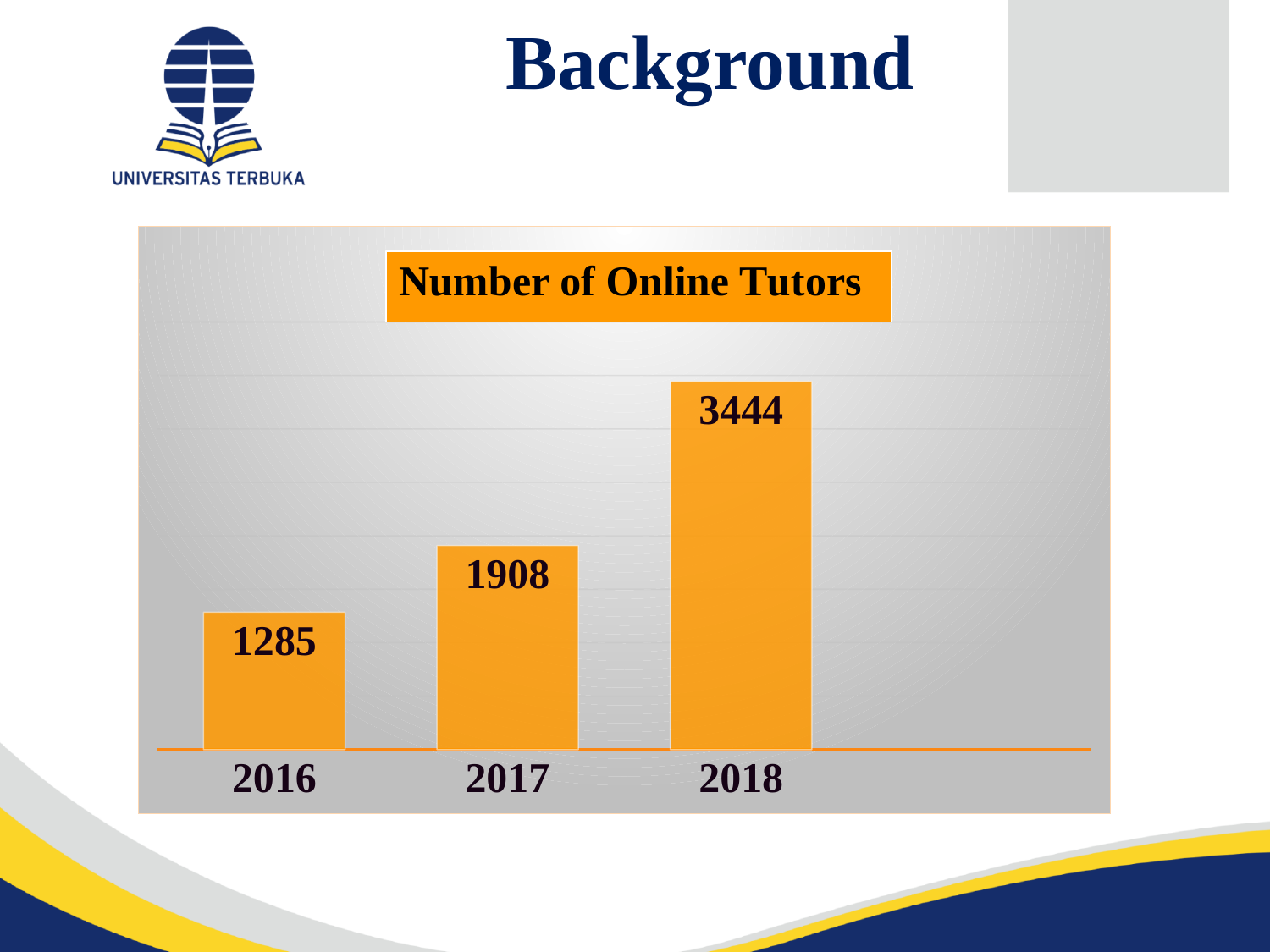
What kind of chart is shown on the slide? Bar chart What is the difference in the number of online tutors between 2018 and 2017? 1536 Which year has more online tutors, 2016 or 2017? 2017 What is the number of online tutors in 2016? 1285 Which year has the highest number of online tutors? 2018 What is the number of online tutors in 2018? 3444 What is the number of online tutors in 2017? 1908 What is the difference in the number of online tutors between 2017 and 2016? 623 How many years are shown on the chart? 3 What is the title of the chart? Number of Online Tutors Does the number of online tutors rise or fall from 2016 to 2018? Rise Which year has the lowest number of online tutors? 2016